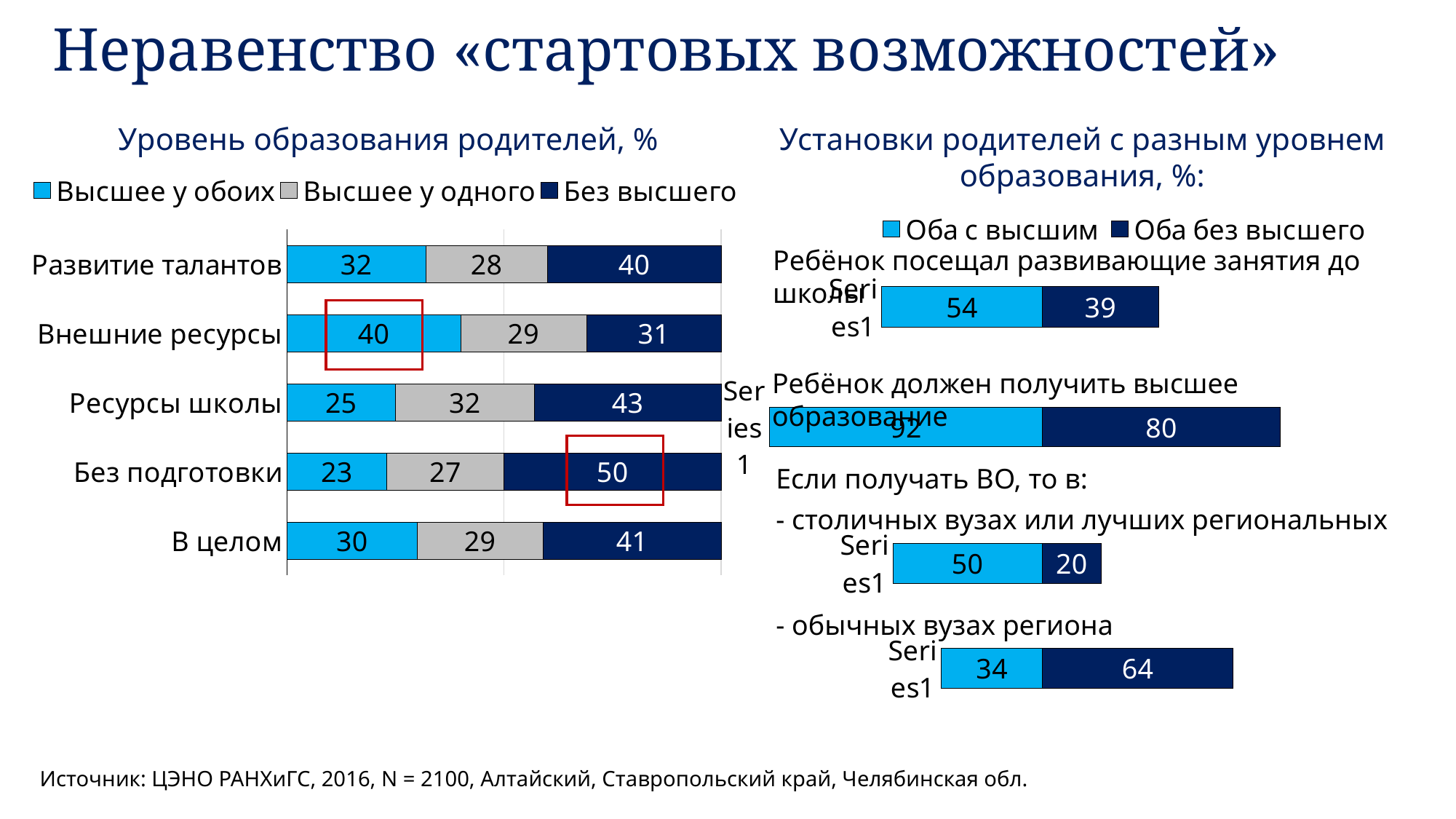
In the right-hand charts 'Установки родителей с разным уровнем образования, %', for 'обычных вузах региона', which is larger: 'Оба с высшим' or 'Оба без высшего'? Оба без высшего In the chart 'Уровень образования родителей, %', what is the value of 'Высшее у одного' for 'Ресурсы школы'? 32 In the chart 'Уровень образования родителей, %', which category has the lowest value for 'Высшее у обоих'? Без подготовки In the right-hand charts 'Установки родителей с разным уровнем образования, %', what is the difference between 'Оба с высшим' and 'Оба без высшего' for 'столичных вузах или лучших региональных'? 30 In the chart 'Уровень образования родителей, %', how many categories are shown? 5 In the chart 'Уровень образования родителей, %', what is the value of 'Высшее у обоих' for 'Внешние ресурсы'? 40 In the chart 'Уровень образования родителей, %', what is the difference between 'Без высшего' for 'Ресурсы школы' and 'Без высшего' for 'Внешние ресурсы'? 12 In the chart 'Уровень образования родителей, %', which category has the highest value for 'Без высшего'? Без подготовки In the right-hand charts 'Установки родителей с разным уровнем образования, %', what is the value of 'Оба без высшего' for 'Ребёнок должен получить высшее образование'? 80 In the chart 'Уровень образования родителей, %', how many series does the legend list? 3 What type of chart is 'Уровень образования родителей, %'? Stacked bar chart In the chart 'Уровень образования родителей, %', what is the value of 'Без высшего' for 'Без подготовки'? 50